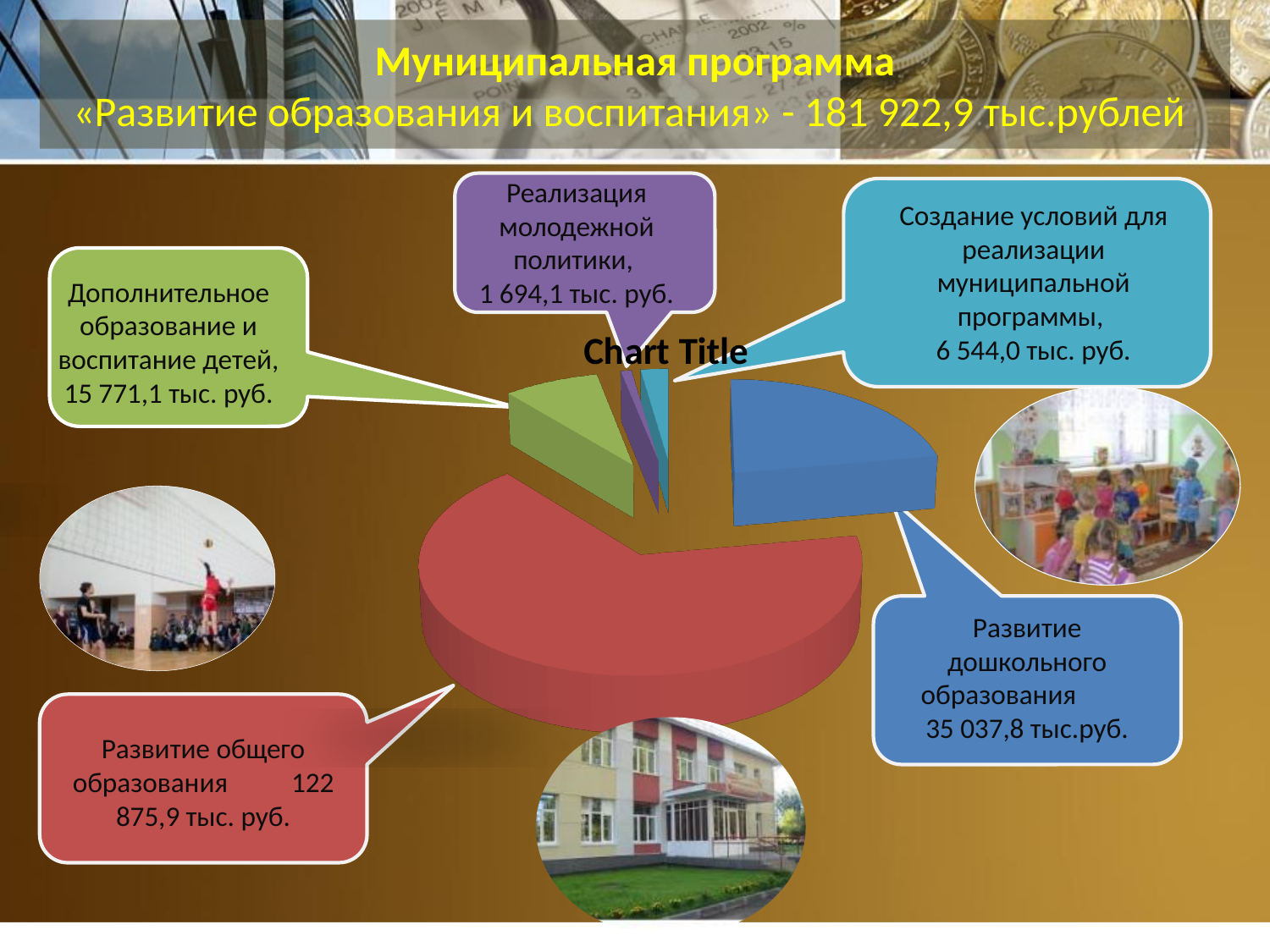
What is the value for «Развитие общего образования»? 122 875,9 тыс. руб. How many slices does the pie chart have? 5 Which is larger: «Развитие дошкольного образования» or «Дополнительное образование и воспитание детей»? Развитие дошкольного образования What is the difference between «Развитие дошкольного образования» and «Дополнительное образование и воспитание детей»? 19 266,7 тыс. руб. What is the value for «Реализация молодежной политики»? 1 694,1 тыс. руб. What is the value for «Развитие дошкольного образования»? 35 037,8 тыс.руб. What is the title printed above the pie chart? Chart Title What is the total of all slices in the pie chart? 181 922,9 тыс. рублей What is the value for «Создание условий для реализации муниципальной программы»? 6 544,0 тыс. руб. Which category has the smallest slice of the pie? Реализация молодежной политики Which category has the largest slice of the pie? Развитие общего образования What kind of chart is shown on the slide? Pie chart